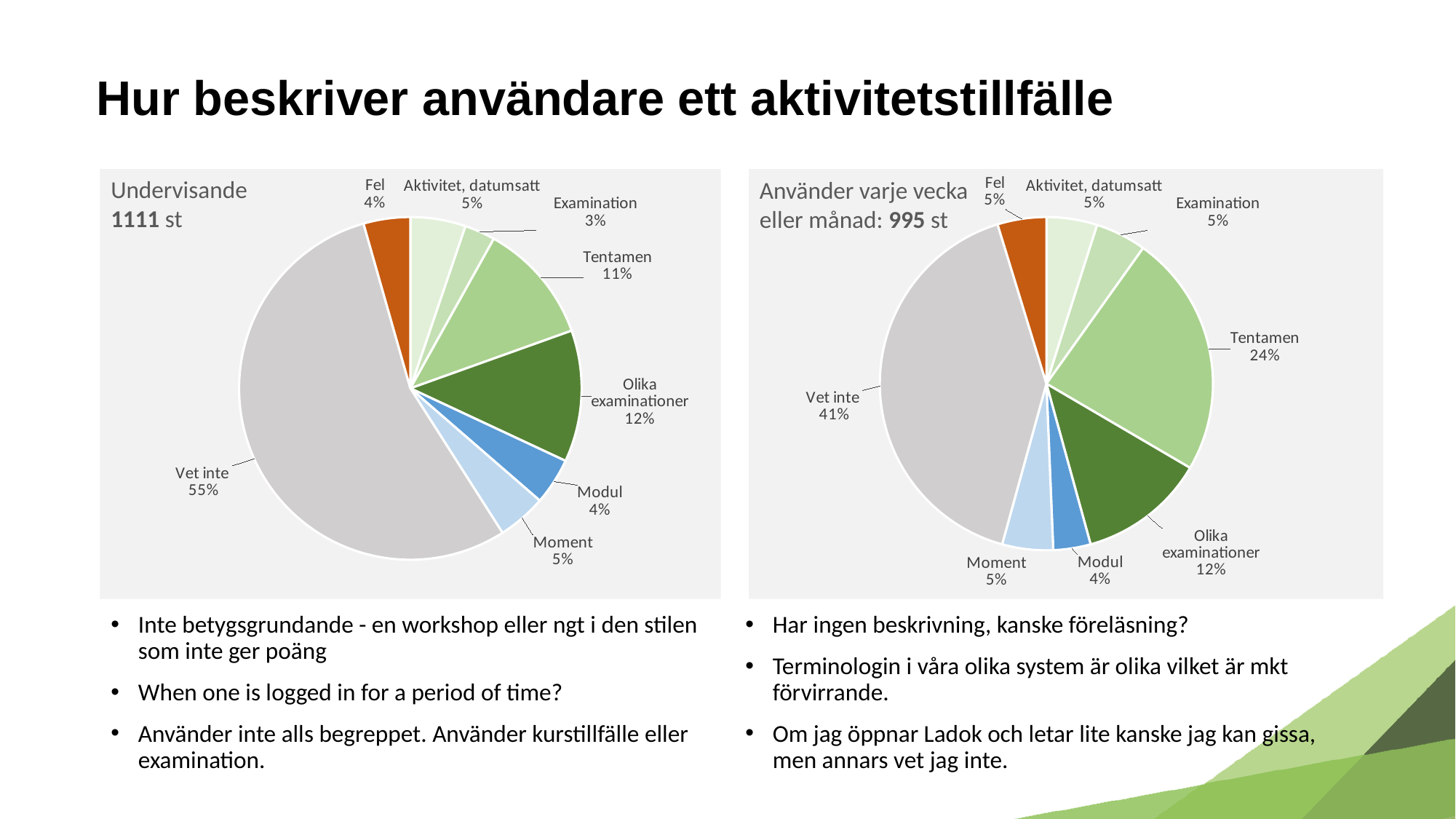
In the left chart (Undervisande 1111 st), what is the value for 'Tentamen'? 11% In the left chart (Undervisande 1111 st), what share of the pie is 'Vet inte'? 55% In the left chart (Undervisande 1111 st), which category has the smallest slice? Examination How many slices does the left chart (Undervisande 1111 st) have? 8 In the right chart (Använder varje vecka eller månad: 995 st), which is larger, 'Tentamen' or 'Olika examinationer'? Tentamen In the right chart (Använder varje vecka eller månad: 995 st), which category has the smallest slice? Modul What kind of chart is the right chart (Använder varje vecka eller månad: 995 st)? Pie chart In the left chart (Undervisande 1111 st), what is the difference between 'Vet inte' and 'Olika examinationer'? 43% In the right chart (Använder varje vecka eller månad: 995 st), what share of the pie is 'Tentamen'? 24% In the right chart (Använder varje vecka eller månad: 995 st), which category has the largest slice? Vet inte What is the title of the left chart? Undervisande 1111 st In the right chart (Använder varje vecka eller månad: 995 st), what is the value for 'Vet inte'? 41%